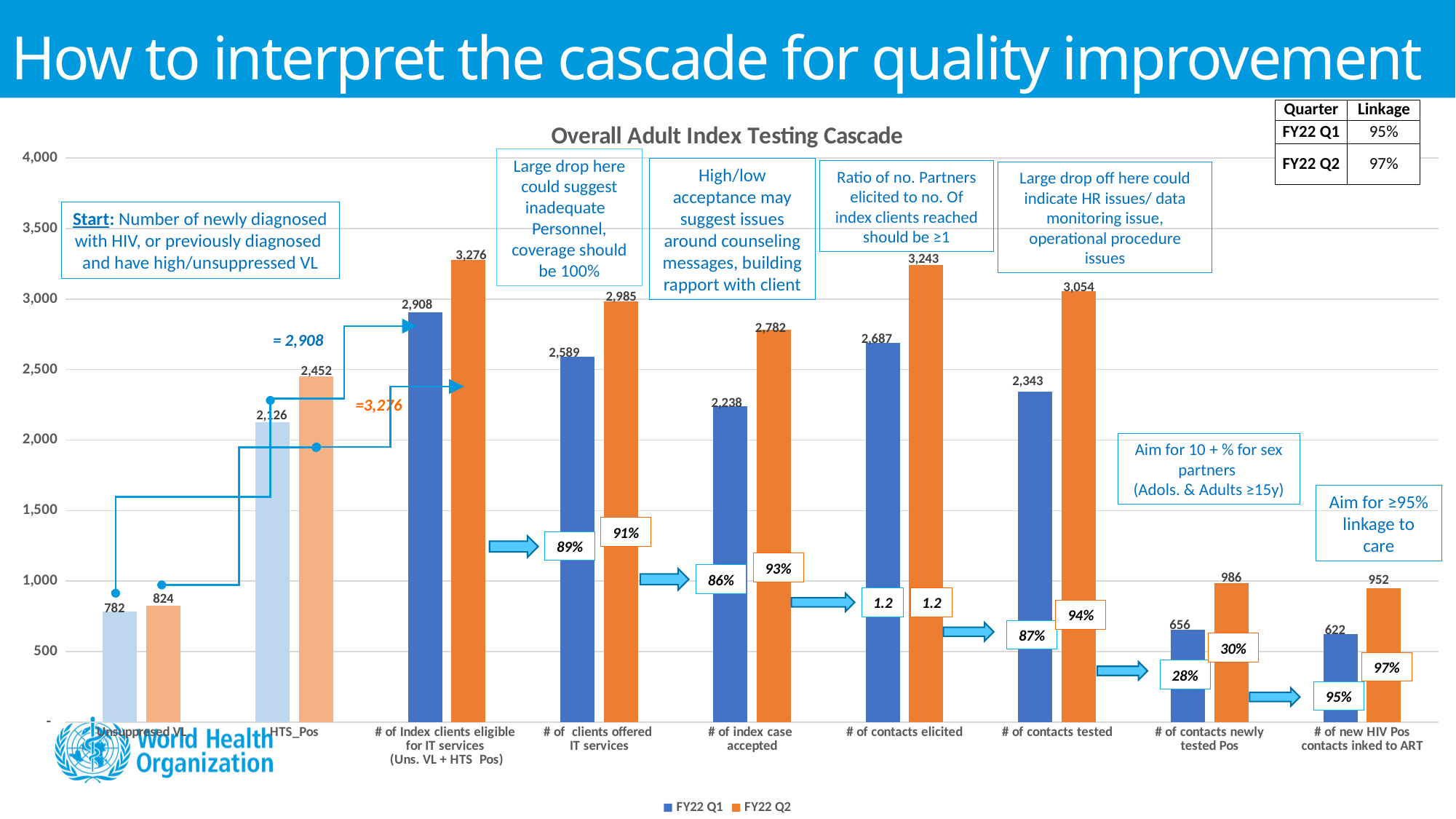
What is the difference between the FY22 Q2 and FY22 Q1 values for # of contacts tested? 711 Which category has the highest FY22 Q2 value? # of Index clients eligible for IT services What is the FY22 Q1 value for # of contacts elicited? 2,687 What is the title of the chart? Overall Adult Index Testing Cascade Which is larger for # of index case accepted: FY22 Q1 or FY22 Q2? FY22 Q2 What is the FY22 Q1 value for Unsuppressed VL? 782 How many series does the chart legend list? 2 Which category has the lowest FY22 Q1 value? # of new HIV Pos contacts linked to ART What is the FY22 Q2 value for # of contacts newly tested Pos? 986 What is the FY22 Q2 value for # of Index clients eligible for IT services? 3,276 What type of chart is shown on the slide? bar chart Is the FY22 Q1 value for HTS_Pos greater or less than 2,000? greater